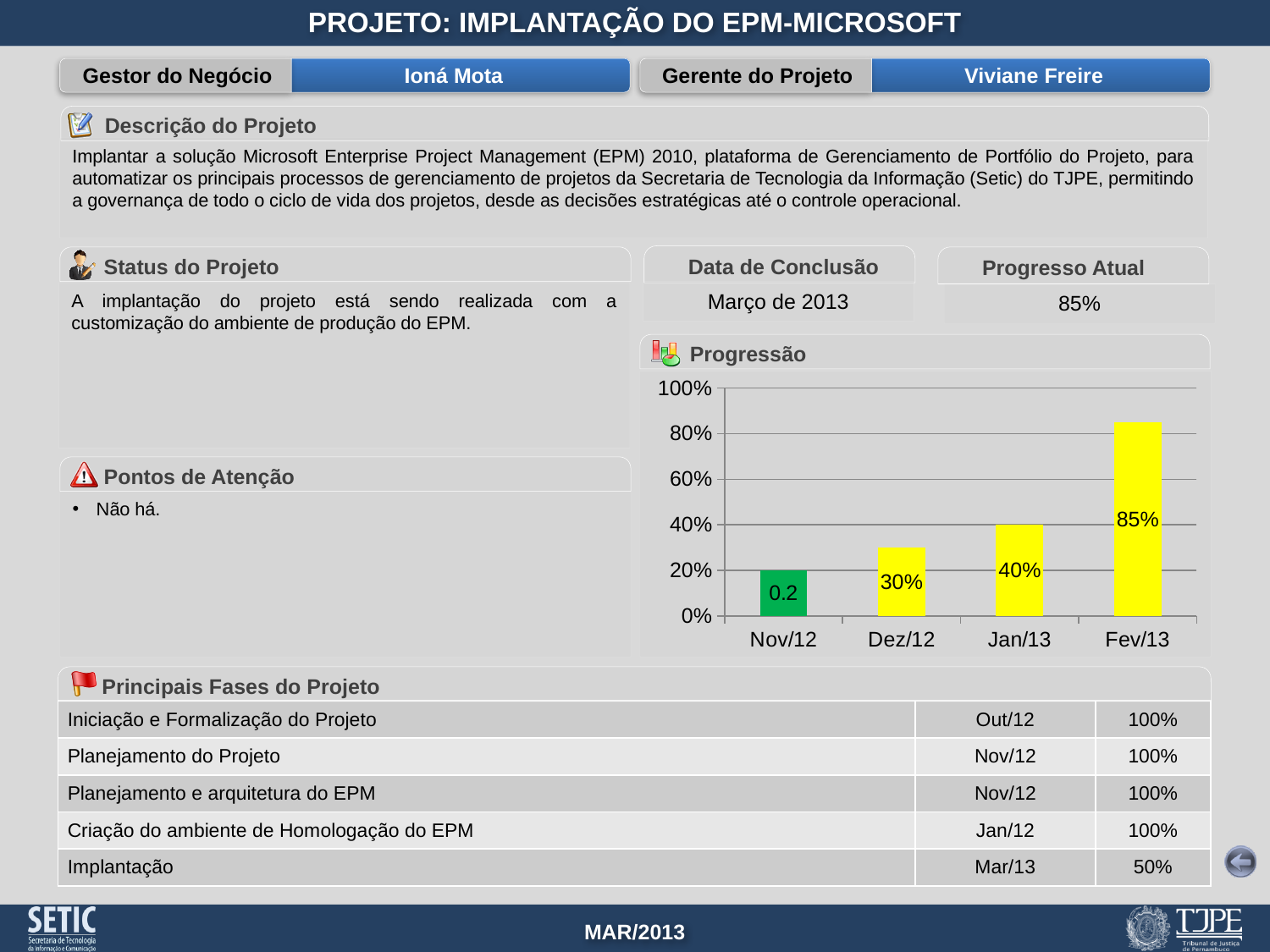
Which is larger in the Progressão chart, the value for Dez/12 or the value for Jan/13? Jan/13 What is the data label shown on the Nov/12 bar in the Progressão chart? 0.2 What value is shown for Fev/13 in the Progressão chart? 85% What is the difference between the Fev/13 and Jan/13 values in the Progressão chart? 45% Which month has the highest value in the Progressão chart? Fev/13 How many months are plotted in the Progressão chart? 4 What value is shown for Dez/12 in the Progressão chart? 30% Which month has the lowest value in the Progressão chart? Nov/12 What kind of chart is the Progressão chart? bar chart Is the value for Fev/13 in the Progressão chart greater or less than 80%? greater Do the values in the Progressão chart rise or fall from Nov/12 to Fev/13? rise What value is shown for Jan/13 in the Progressão chart? 40%